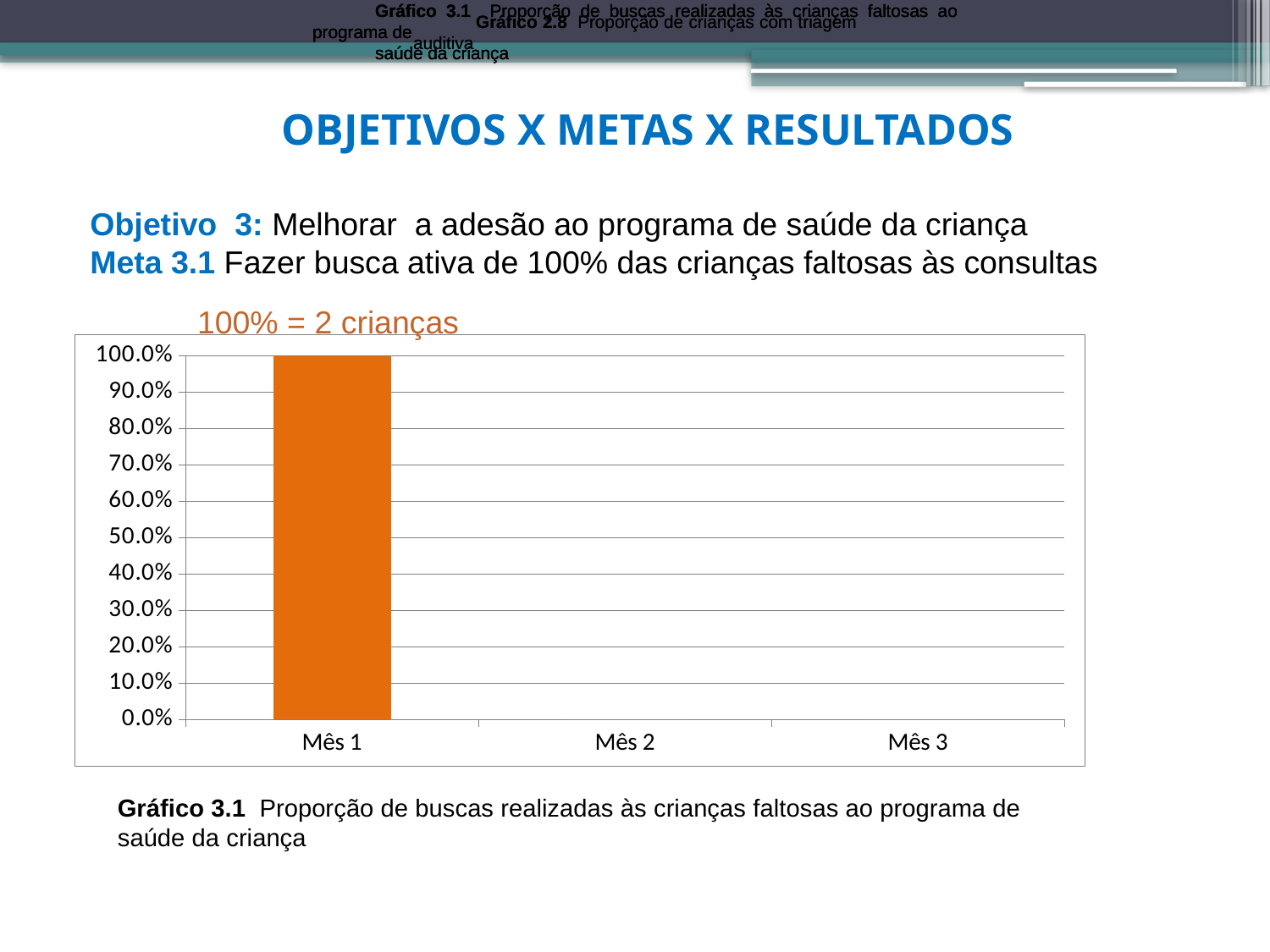
What colour is the bar for Mês 1? orange What kind of chart is shown on the slide? bar chart Is the value for Mês 2 greater or less than 50.0%? less What is the value for Mês 1 in the chart? 100.0% Is the value for Mês 1 greater or less than 90.0%? greater How many categories are shown on the x axis of the chart? 3 Do the values rise or fall from Mês 1 to Mês 3? fall According to the note above the chart, how many children does 100% correspond to? 2 crianças Is the value for Mês 3 greater or less than 10.0%? less What is the highest value shown on the y axis of the chart? 100.0% Which category has the highest value in the chart? Mês 1 Which is larger, the value for Mês 1 or the value for Mês 2? Mês 1